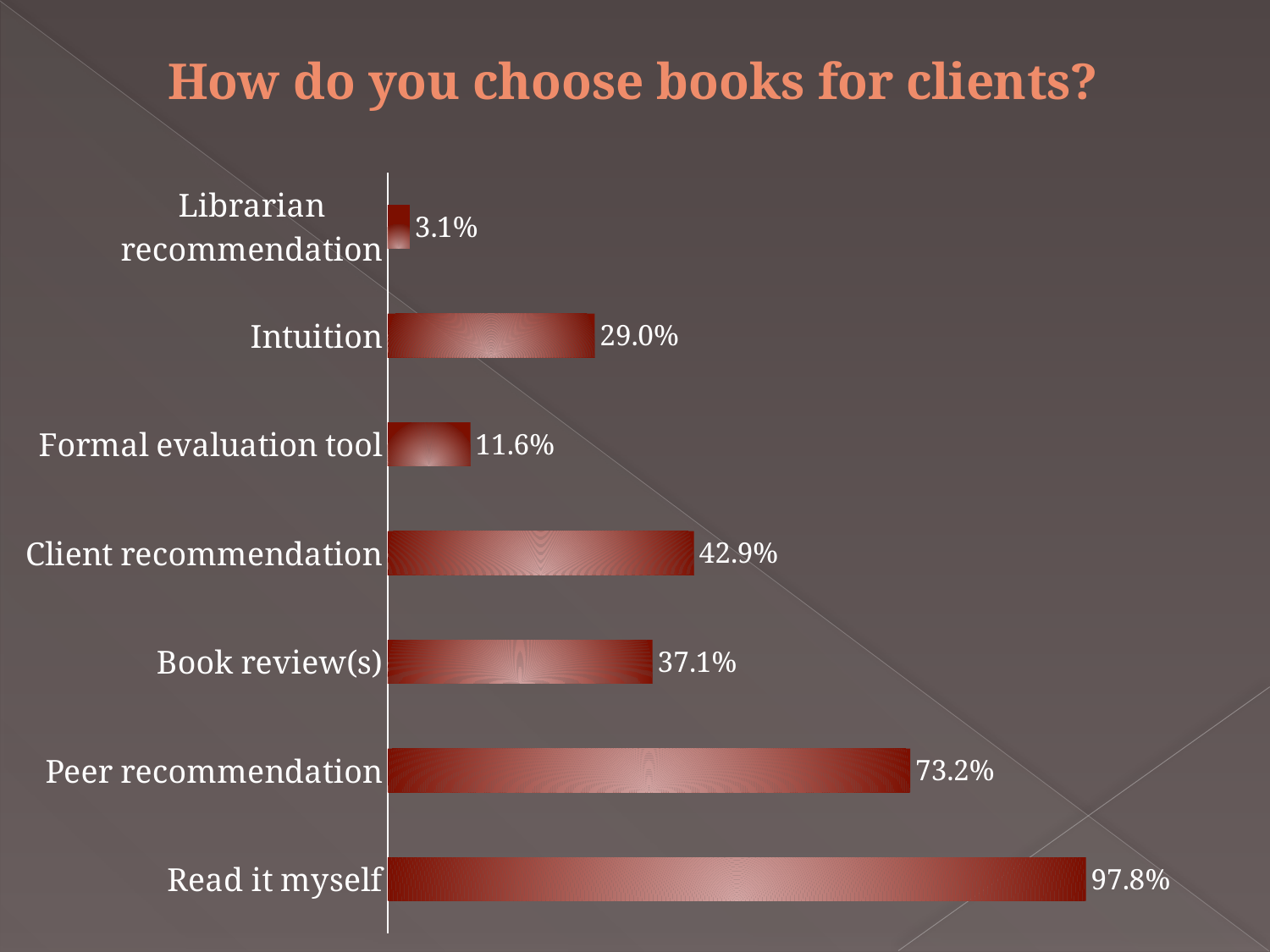
How many categories are shown in the chart? 7 What is the difference between Read it myself and Peer recommendation? 24.6% What kind of chart is shown on the slide? Bar chart What is the value for Intuition? 29.0% Which category has the lowest value? Librarian recommendation Which category has the highest value? Read it myself What is the value for Formal evaluation tool? 11.6% Which is larger, Intuition or Formal evaluation tool? Intuition What is the title of the chart? How do you choose books for clients? What is the difference between Client recommendation and Book review(s)? 5.8% What percentage of respondents choose books by reading them themselves? 97.8% What is the value for Peer recommendation? 73.2%